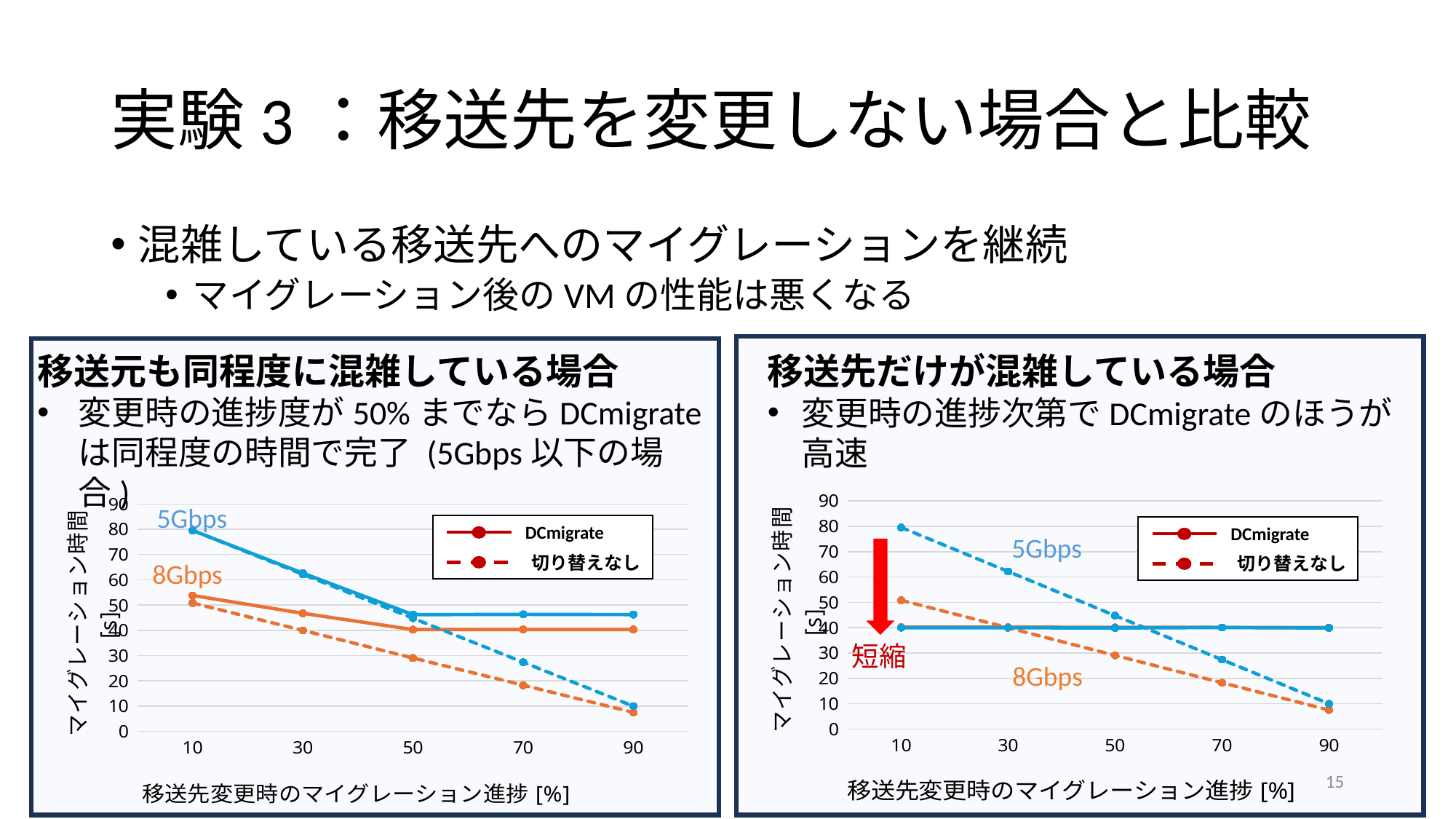
In the right chart (移送先だけが混雑している場合), at 90% progress, which 5Gbps series has the larger migration time: DCmigrate or 切り替えなし? DCmigrate In the left chart (移送元も同程度に混雑している場合), how many x-axis points (progress values) are plotted? 5 In the left chart (移送元も同程度に混雑している場合), is the 5Gbps DCmigrate value at 90% greater or less than 40? greater In the left chart (移送元も同程度に混雑している場合), is the 5Gbps 切り替えなし value at 90% greater or less than 20? less What is the x-axis label of the left chart (移送元も同程度に混雑している場合)? 移送先変更時のマイグレーション進捗 [%] In the right chart (移送先だけが混雑している場合), how many series does the legend list? 2 In the left chart (移送元も同程度に混雑している場合), does the 8Gbps 切り替えなし line rise or fall as progress increases from 10% to 90%? fall What kind of chart is shown on the left (移送元も同程度に混雑している場合)? line chart In the right chart (移送先だけが混雑している場合), at 10% progress, which 5Gbps series has the larger migration time: DCmigrate or 切り替えなし? 切り替えなし In the right chart (移送先だけが混雑している場合), is the 5Gbps 切り替えなし value at 10% greater or less than 70? greater In the right chart (移送先だけが混雑している場合), does the 5Gbps DCmigrate line rise, fall, or stay flat from 10% to 90%? stay flat